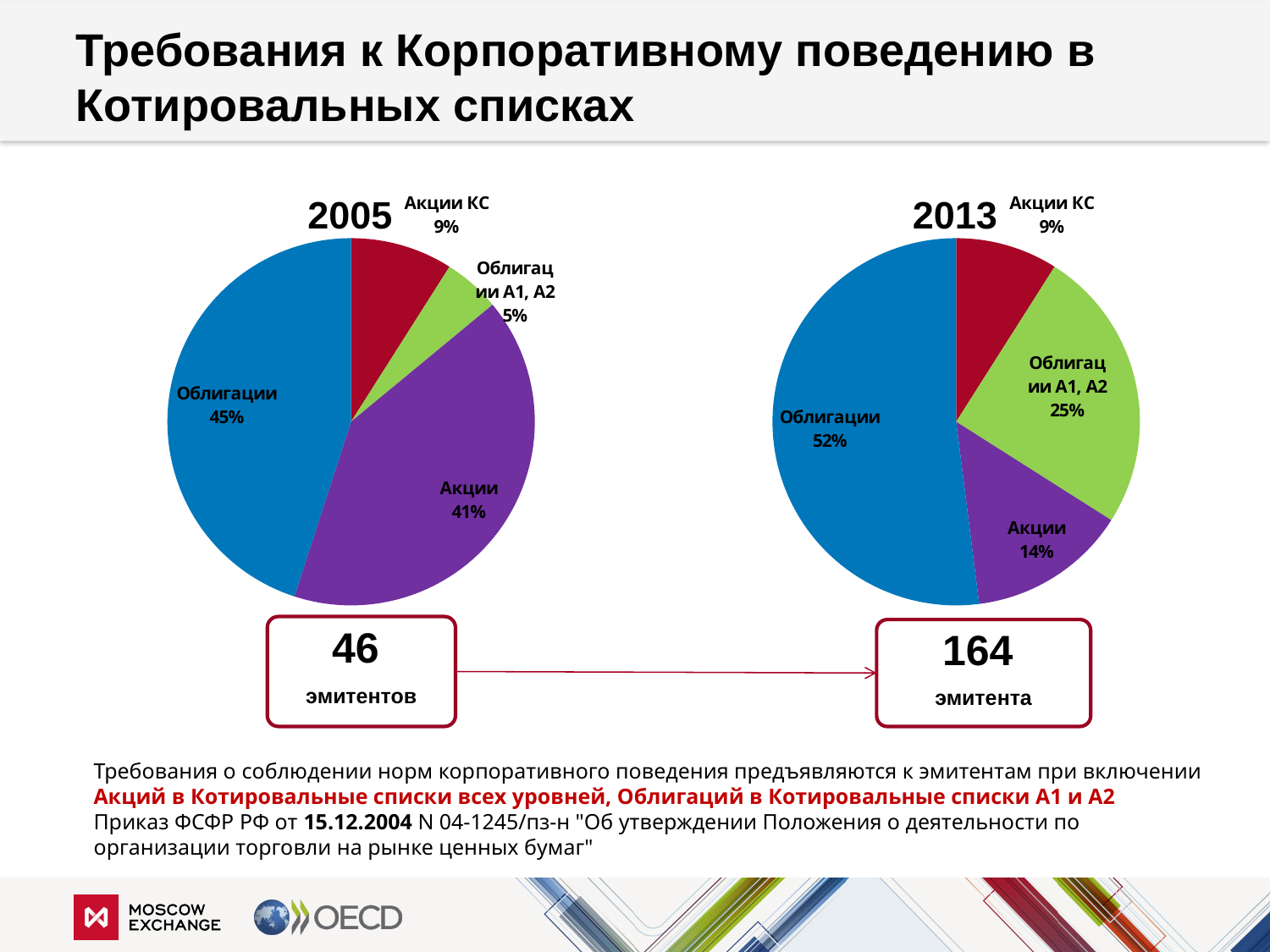
In the 2013 pie chart, what share is labelled for Облигации А1, А2? 25% In the 2005 pie chart, which is larger: the share of Акции КС or the share of Облигации А1, А2? Акции КС In the 2013 pie chart, which category has the largest share? Облигации In the 2013 pie chart, what share is labelled for Акции? 14% In the 2013 pie chart, what is the difference between the shares of Облигации А1, А2 and Акции? 11% How many slices does the 2013 pie chart have? 4 In the 2005 pie chart, which category has the smallest share? Облигации А1, А2 In the 2005 pie chart, what is the difference between the shares of Облигации and Акции? 4% What type of chart is used for the 2005 data? Pie chart What share does Акции КС have in the 2013 pie chart? 9% What colour is the Облигации slice in both pie charts? Blue In the 2005 pie chart, what share is labelled for Облигации? 45%